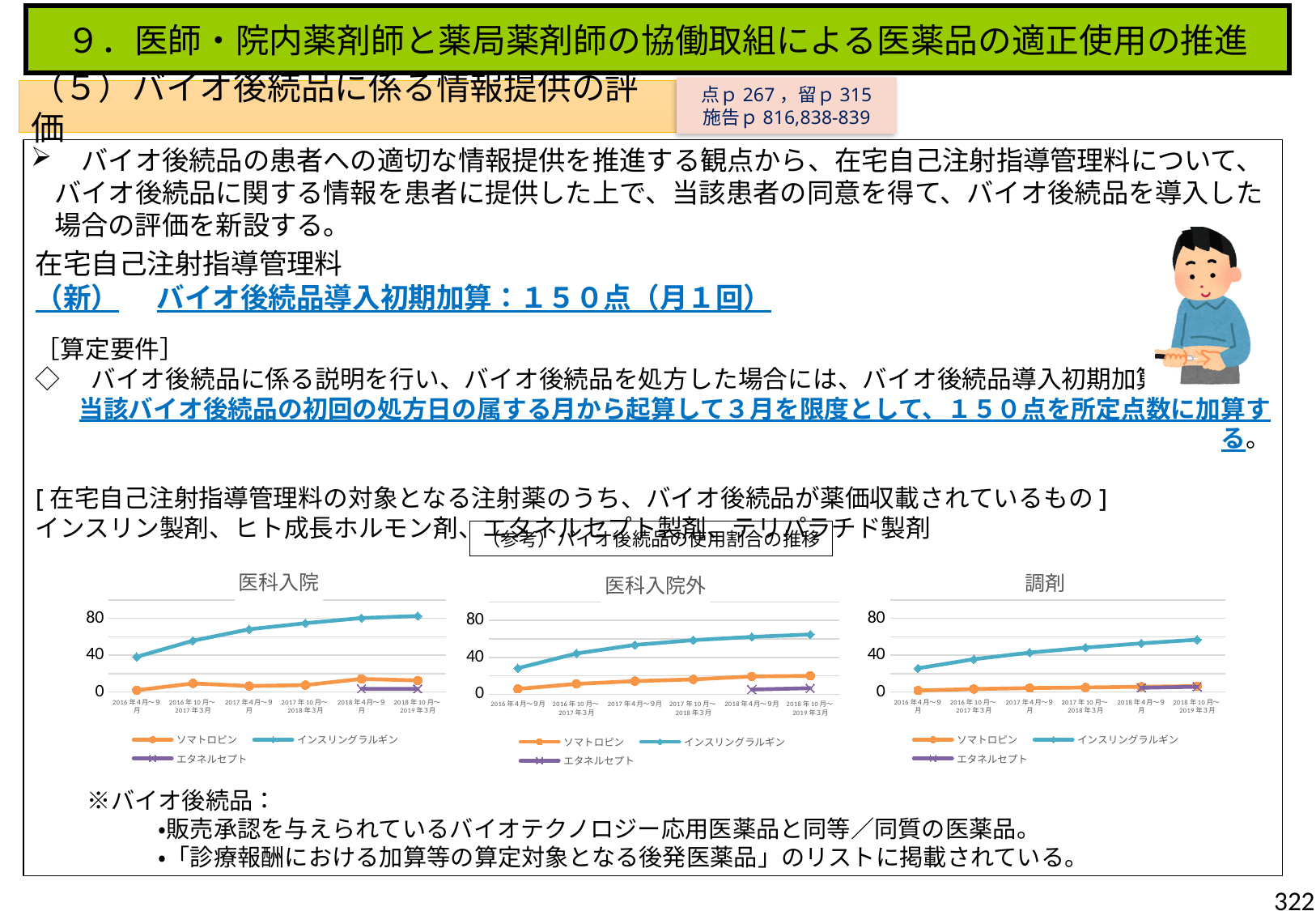
How many series does the legend of the 医科入院外 chart list? 3 In the 医科入院 chart, is the value for ソマトロピン in 2018年10月～2019年3月 greater or less than 40? less In the 医科入院外 chart, is the value for インスリングラルギン in 2016年4月～9月 greater or less than 40? less How many time periods are shown on the x axis of the 調剤 chart? 6 In the 調剤 chart, which series has the highest value in 2018年10月～2019年3月? インスリングラルギン In the 医科入院 chart, does the インスリングラルギン line rise or fall from 2016年4月～9月 to 2018年10月～2019年3月? rise In the 医科入院外 chart, which is larger in 2018年10月～2019年3月: ソマトロピン or エタネルセプト? ソマトロピン Which series is shown in orange in the 調剤 chart? ソマトロピン In the 調剤 chart, is the value for インスリングラルギン in 2018年10月～2019年3月 greater or less than 40? greater What kind of chart is the 医科入院 chart? line chart What is the title of the chart on the right of the slide? 調剤